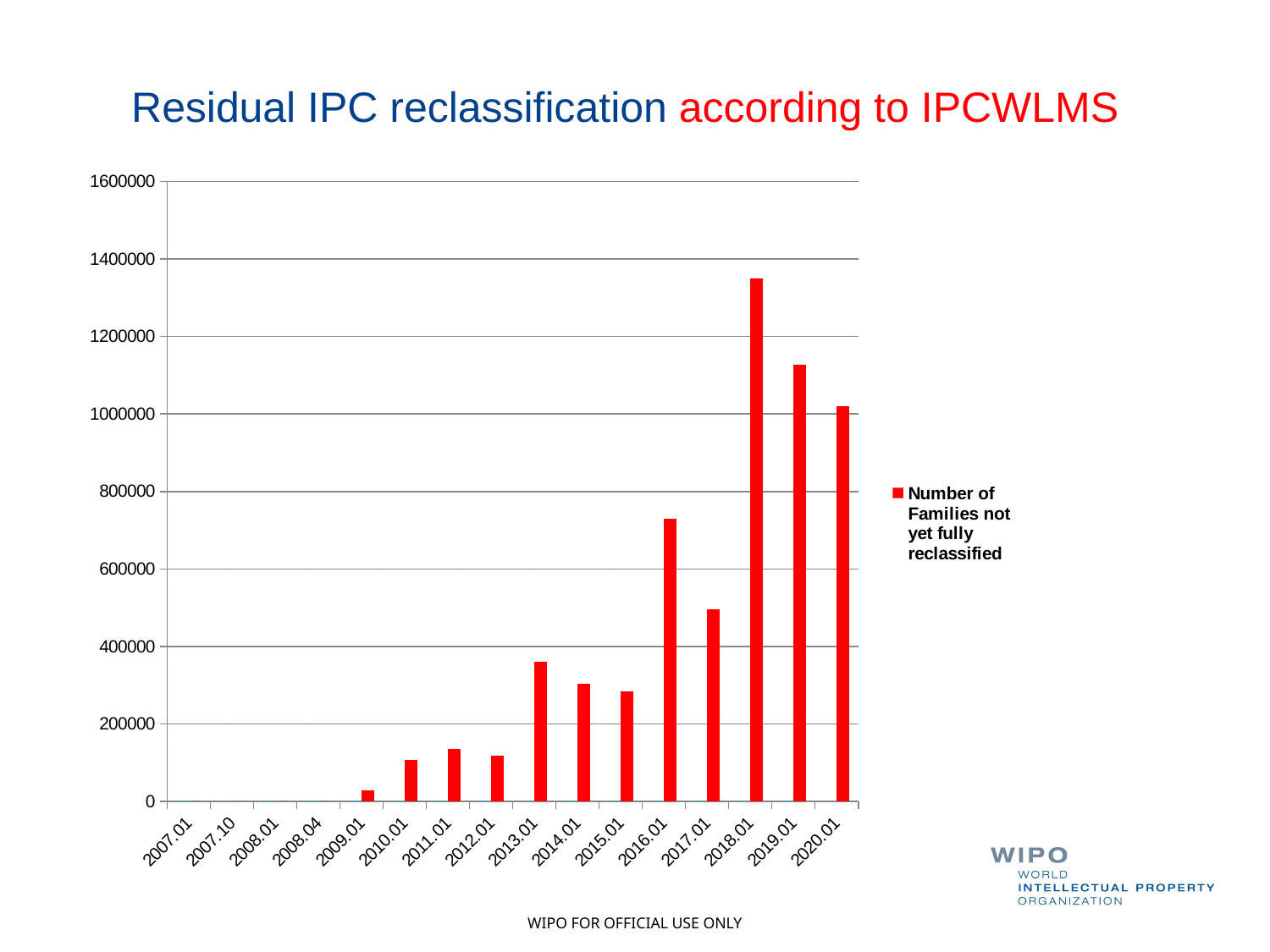
Is the value for 2018.01 greater or less than 1200000? greater Which is larger, the value for 2018.01 or the value for 2019.01? 2018.01 How many series does the legend list? 1 Which category has the highest number of families not yet fully reclassified? 2018.01 Which is larger, the value for 2016.01 or the value for 2017.01? 2016.01 Is the value for 2013.01 greater or less than 400000? less Is the value for 2010.01 greater or less than 200000? less What kind of chart is shown on the slide? bar chart How many categories are shown on the x axis? 16 What is the name of the series shown in the legend? Number of Families not yet fully reclassified From 2018.01 to 2020.01, do the values rise or fall? fall